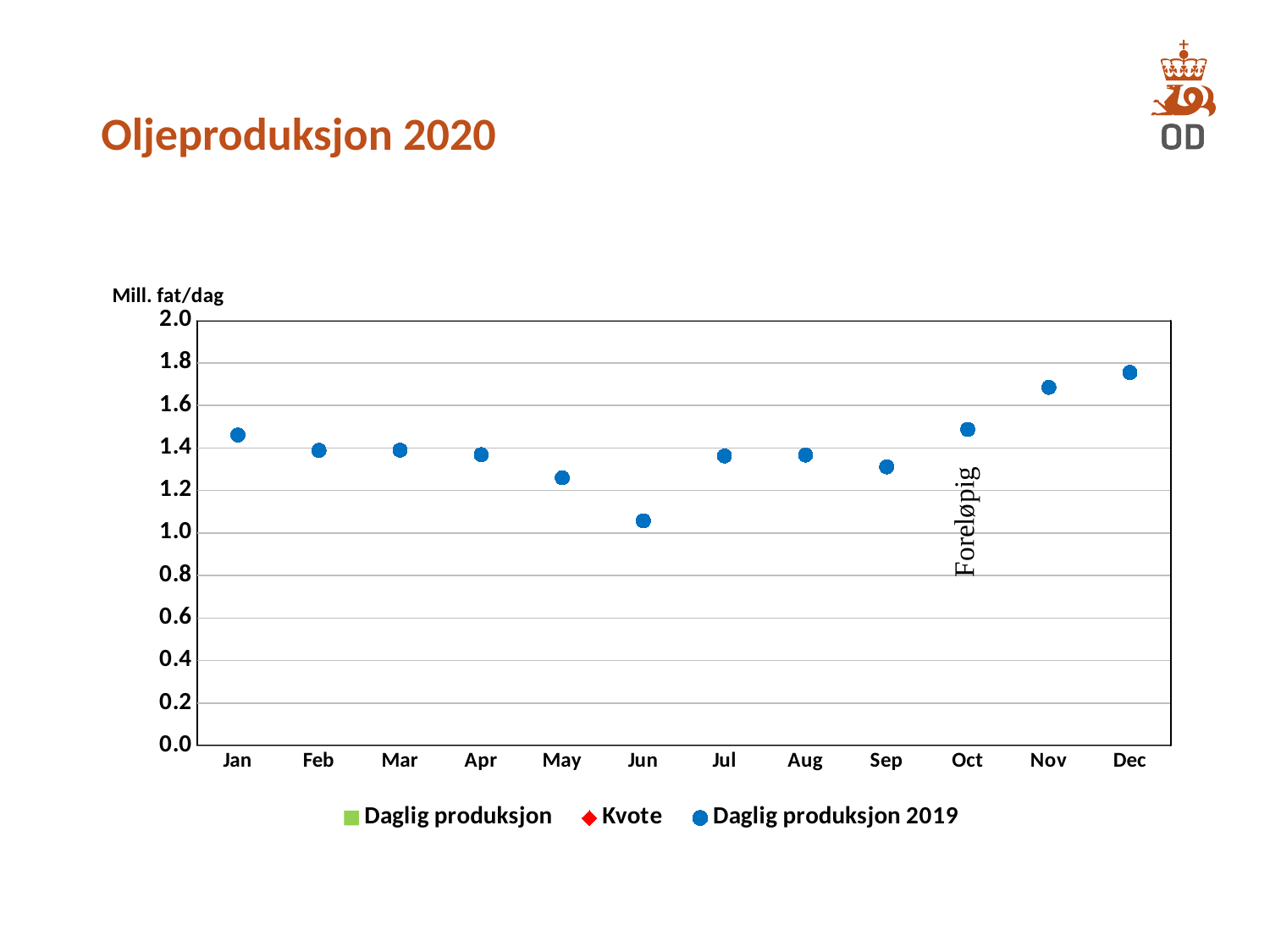
In which month is the Daglig produksjon 2019 value lowest? Jun What unit is shown on the vertical axis label? Mill. fat/dag Is the Daglig produksjon 2019 value for Jun greater or less than 1.2? less Is the Daglig produksjon 2019 value for Sep greater or less than 1.4? less What kind of chart is this? Scatter (dot) chart How many months are shown on the x axis? 12 Do the Daglig produksjon 2019 values rise or fall from Sep to Dec? rise Which month has the larger Daglig produksjon 2019 value, Jan or Jun? Jan How many series does the legend list? 3 Is the Daglig produksjon 2019 value for Dec greater or less than 1.6? greater In which month is the Daglig produksjon 2019 value highest? Dec What is the title of the chart on the slide? Oljeproduksjon 2020